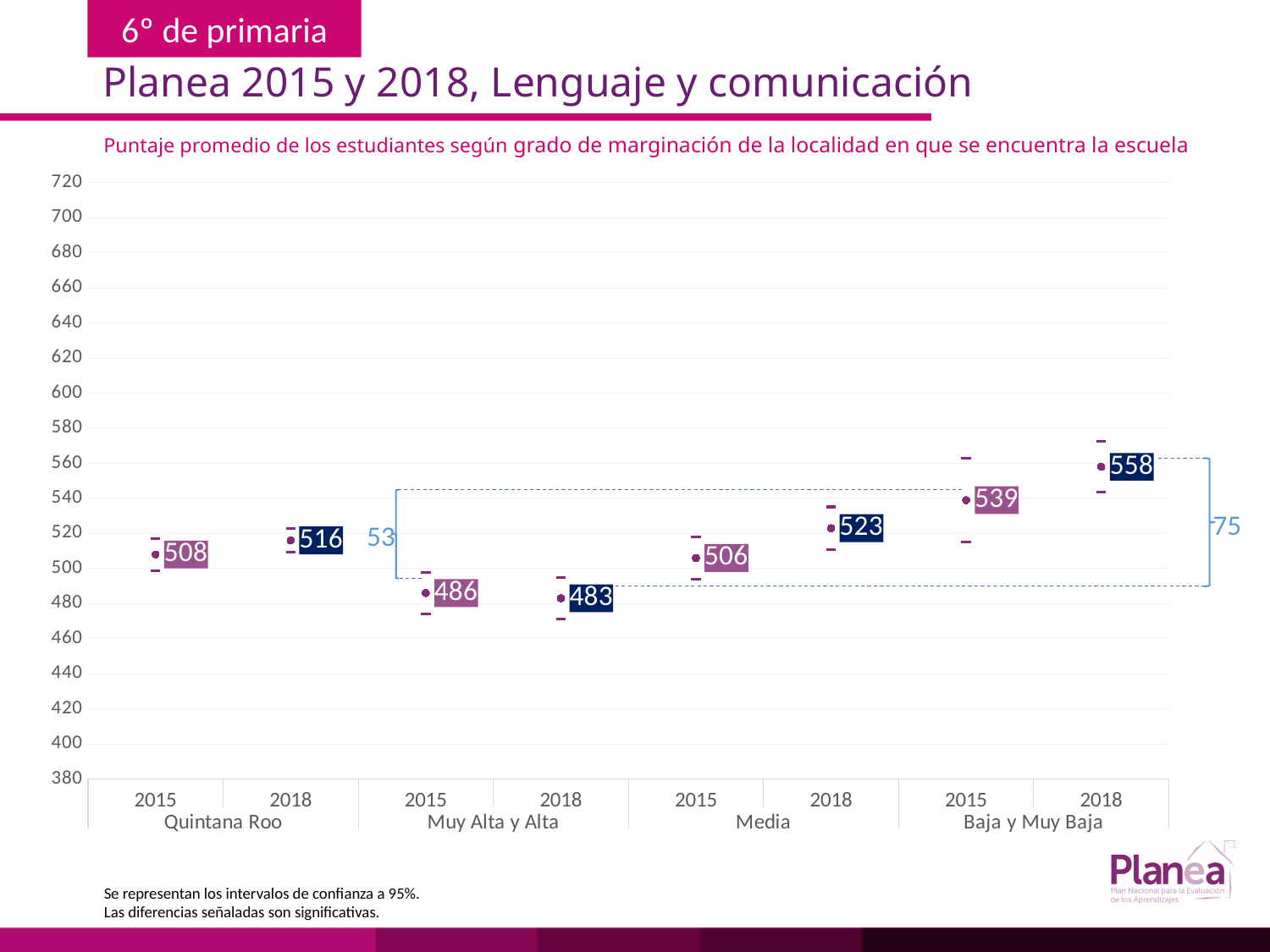
How many data points (group-year combinations) are plotted on the chart? 8 What is the 2018 average score for the Media marginación group? 523 Did the average score for Muy Alta y Alta rise or fall from 2015 to 2018? Fall What is the subtitle of the chart? Puntaje promedio de los estudiantes según grado de marginación de la localidad en que se encuentra la escuela What is the 2015 average score for the Baja y Muy Baja marginación group? 539 What is the 2015 average score for Quintana Roo? 508 What is the 2018 average score for the Muy Alta y Alta marginación group? 483 What is the difference between the 2018 and 2015 scores for the Media group? 17 Which is larger: the 2015 score for Quintana Roo or the 2015 score for Media? Quintana Roo (508) Which group and year has the highest average score? Baja y Muy Baja, 2018 (558) Which group and year has the lowest average score? Muy Alta y Alta, 2018 (483) What is the difference between the 2018 score for Baja y Muy Baja and the 2018 score for Muy Alta y Alta, as annotated on the chart? 75